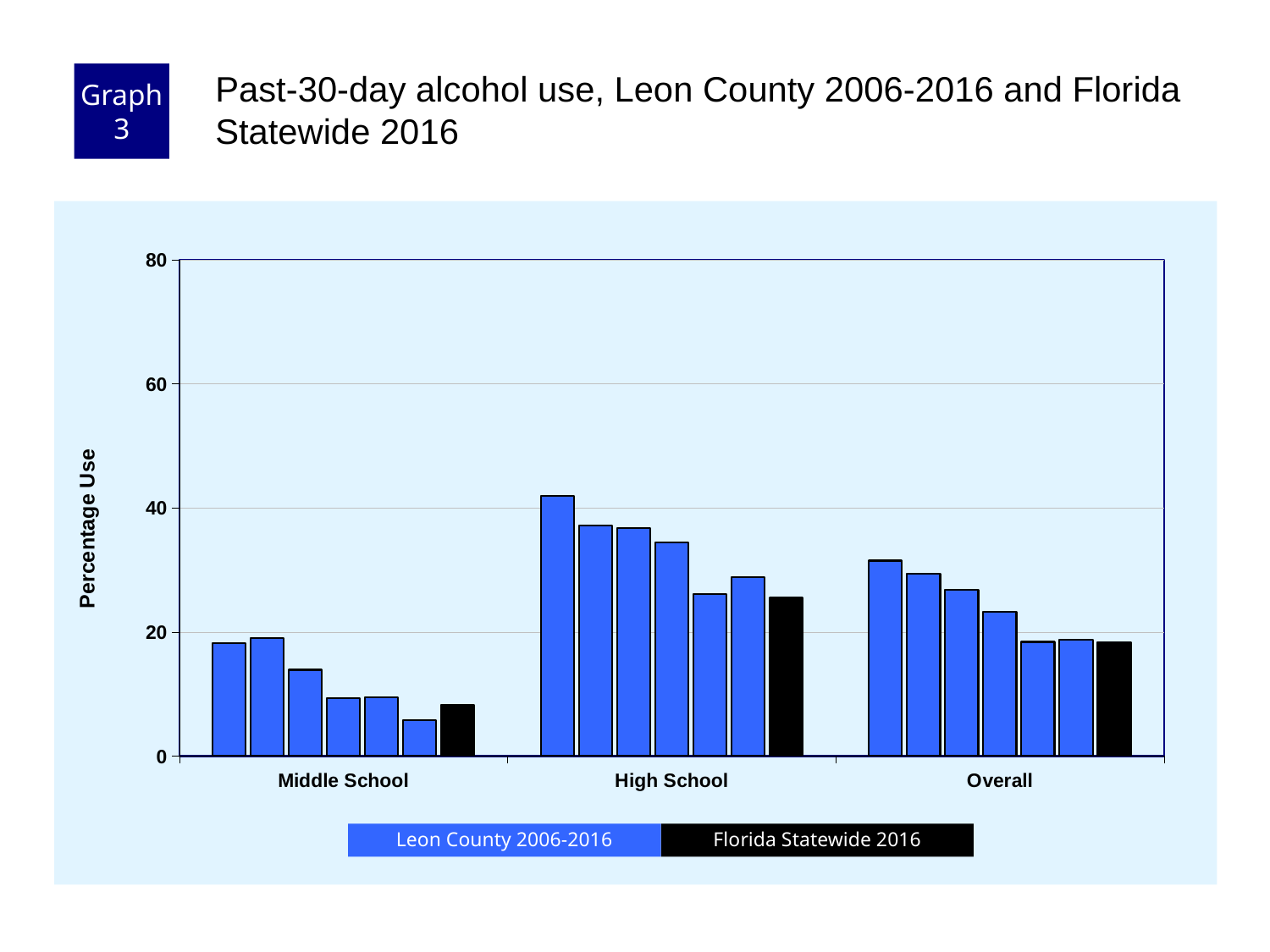
How many series does the legend list? 2 Which is larger, the Florida Statewide 2016 value for High School or for Middle School? High School Which category has the highest bars overall? High School How many categories are shown on the x axis? 3 What kind of chart is shown on the slide? bar chart Is the tallest Leon County bar for High School greater or less than 40? greater Is the tallest Leon County bar for Overall greater or less than 40? less Which category has the lowest bars overall? Middle School Do the Leon County 2006-2016 bars within the High School group rise or fall from left to right? fall What is the label on the y axis? Percentage Use Is the Florida Statewide 2016 value for High School greater or less than 20? greater